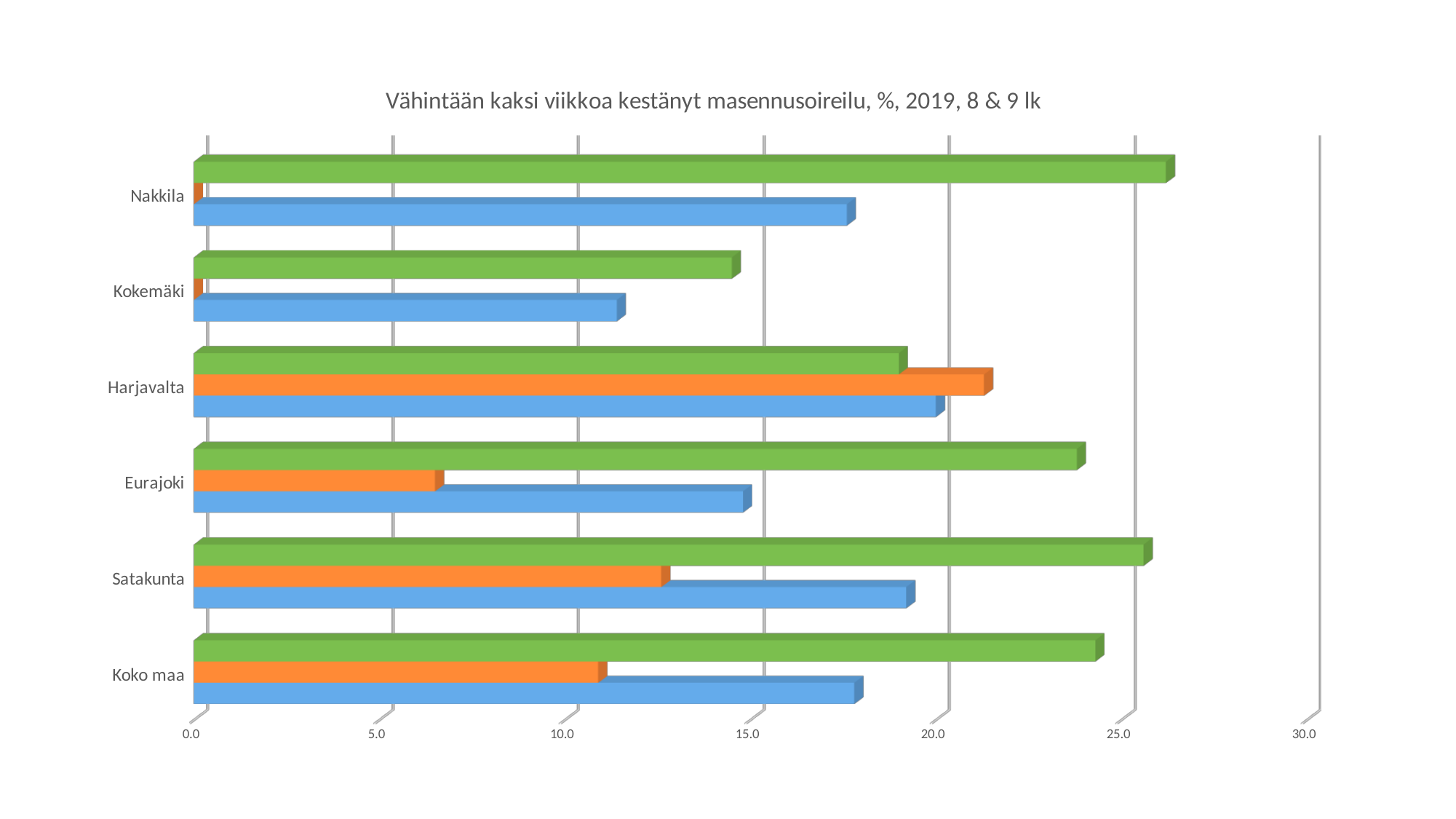
How many categories are shown on the vertical axis of the chart? 6 What kind of chart is shown on the slide? bar chart How many differently coloured bar series are plotted for each category? 3 Is the value of the blue bar for Koko maa greater or less than 20.0? less Is the value of the blue bar for Kokemäki greater or less than 10.0? greater Is the value of the orange bar for Harjavalta greater or less than 20.0? greater What is the title of the chart? Vähintään kaksi viikkoa kestänyt masennusoireilu, %, 2019, 8 & 9 lk Which category has the highest value for the orange bar series? Harjavalta Which category has the lowest value for the green bar series? Kokemäki